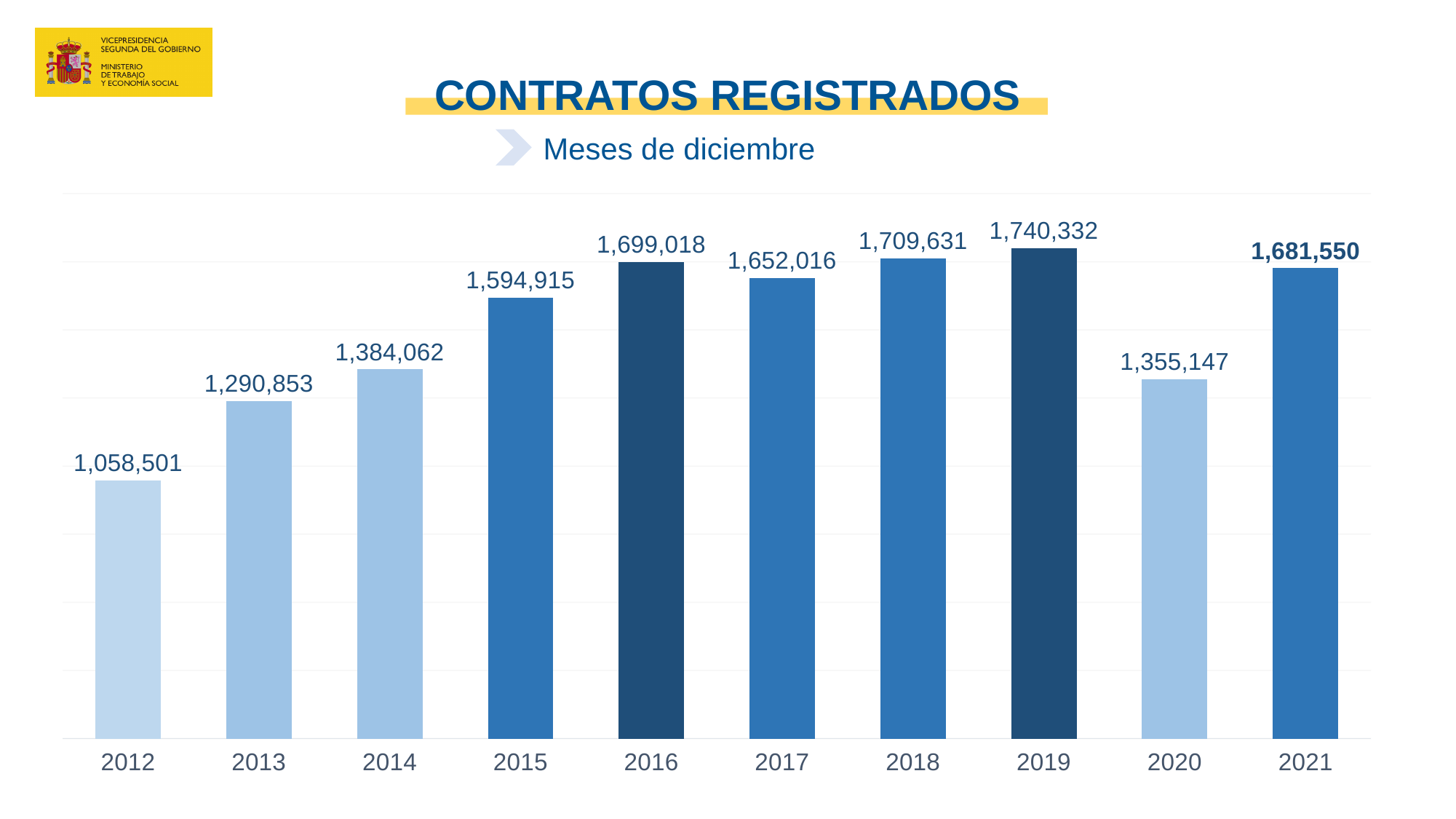
Which year has the highest value? 2019 What kind of chart is shown on the slide? Bar chart What is the value shown for 2017? 1,652,016 What is the value shown for 2012? 1,058,501 Which is larger, the value for 2014 or the value for 2020? 2014 Which is larger, the value for 2018 or the value for 2017? 2018 What is the difference between the values for 2021 and 2020? 326,403 How many years are shown on the x axis? 10 What is the difference between the values for 2019 and 2012? 681,831 What is the value shown for 2021? 1,681,550 Which year has the lowest value? 2012 Do the values rise or fall from 2012 to 2016? Rise